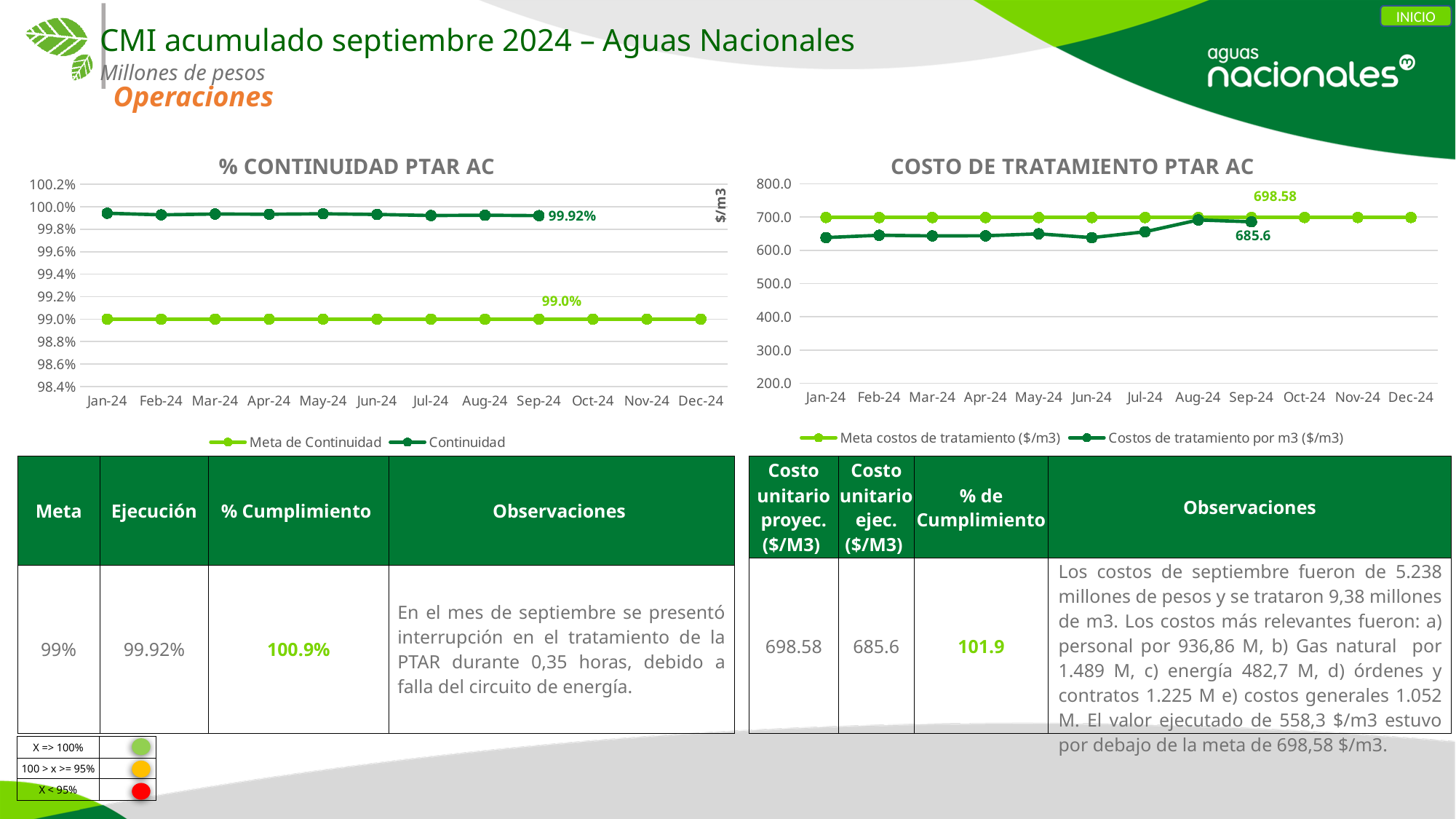
What kind of chart is the '% CONTINUIDAD PTAR AC' chart? Line chart In the 'COSTO DE TRATAMIENTO PTAR AC' chart, what value is labelled for the Meta costos de tratamiento series? 698.58 In the '% CONTINUIDAD PTAR AC' chart, which is larger at Sep-24: Continuidad or Meta de Continuidad? Continuidad In the 'COSTO DE TRATAMIENTO PTAR AC' chart, what is the difference between the Meta costos de tratamiento label and the Sep-24 Costos de tratamiento por m3 label? 12.98 In the 'COSTO DE TRATAMIENTO PTAR AC' chart, is the Costos de tratamiento por m3 value at Jan-24 greater or less than 700.0? less In the 'COSTO DE TRATAMIENTO PTAR AC' chart, does the Costos de tratamiento por m3 series rise or fall from Jan-24 to Sep-24? Rise In the '% CONTINUIDAD PTAR AC' chart, what is the Continuidad value labelled at Sep-24? 99.92% How many months are shown on the x axis of the 'COSTO DE TRATAMIENTO PTAR AC' chart? 12 In the '% CONTINUIDAD PTAR AC' chart, what is the difference between the labelled Continuidad value at Sep-24 and the Meta de Continuidad value? 0.92% In the 'COSTO DE TRATAMIENTO PTAR AC' chart, what is the labelled value of Costos de tratamiento por m3 at Sep-24? 685.6 In the '% CONTINUIDAD PTAR AC' chart, what value is labelled for the Meta de Continuidad series? 99.0% In the '% CONTINUIDAD PTAR AC' chart, how many series does the legend list? 2